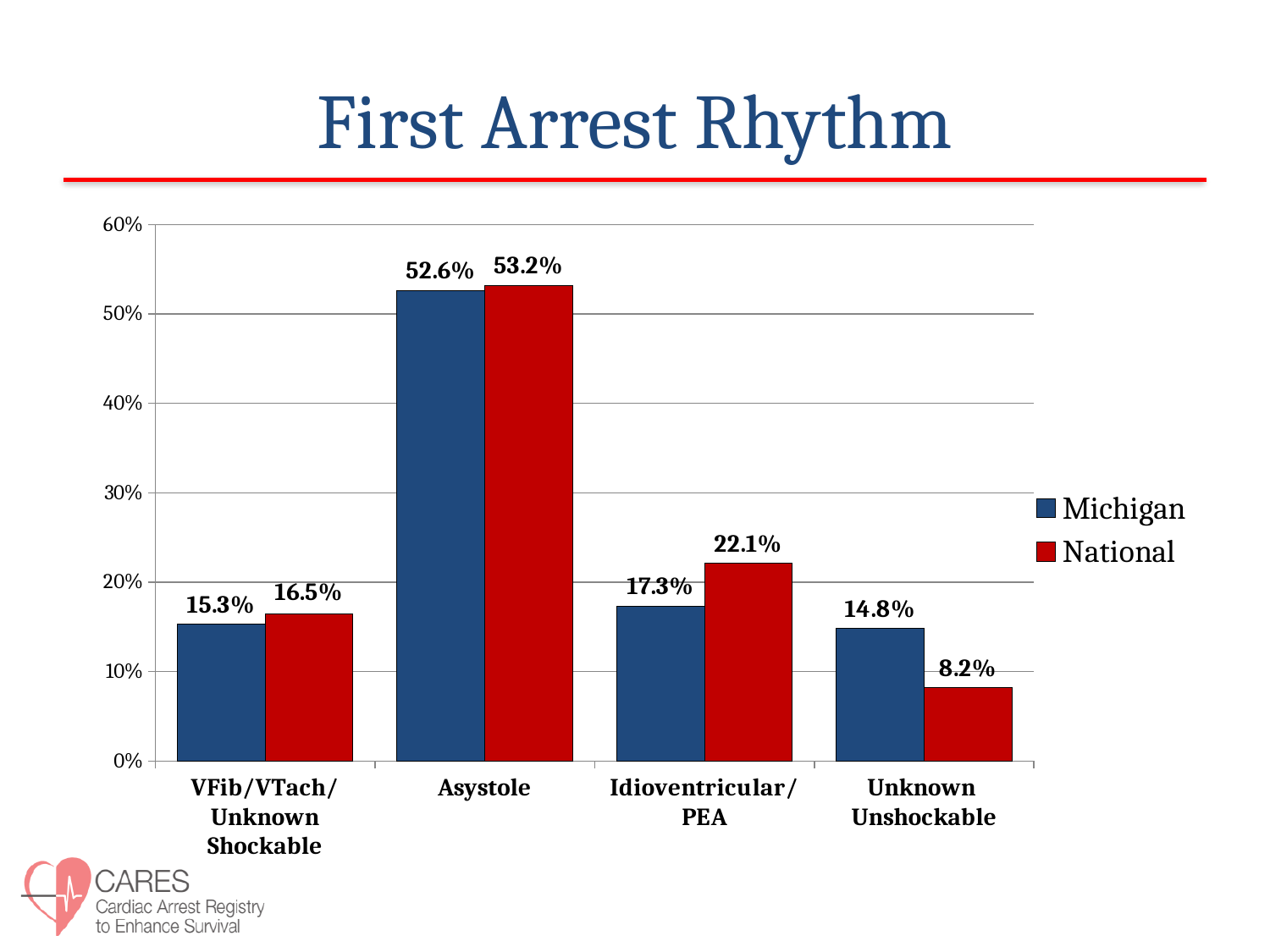
What is the National value for Unknown Unshockable? 8.2% What is the difference between the Michigan and National values for Unknown Unshockable? 6.6% How many series does the legend list? 2 What is the National value for Idioventricular/PEA? 22.1% Which category has the lowest National value? Unknown Unshockable Which category has the highest Michigan value? Asystole How many categories are shown on the x axis? 4 What kind of chart is shown on the slide? bar chart What is the difference between the National and Michigan values for Idioventricular/PEA? 4.8% What is the Michigan value for Asystole? 52.6% Is the National value for Asystole greater or less than 50%? greater Which is larger for Unknown Unshockable, the Michigan value or the National value? Michigan